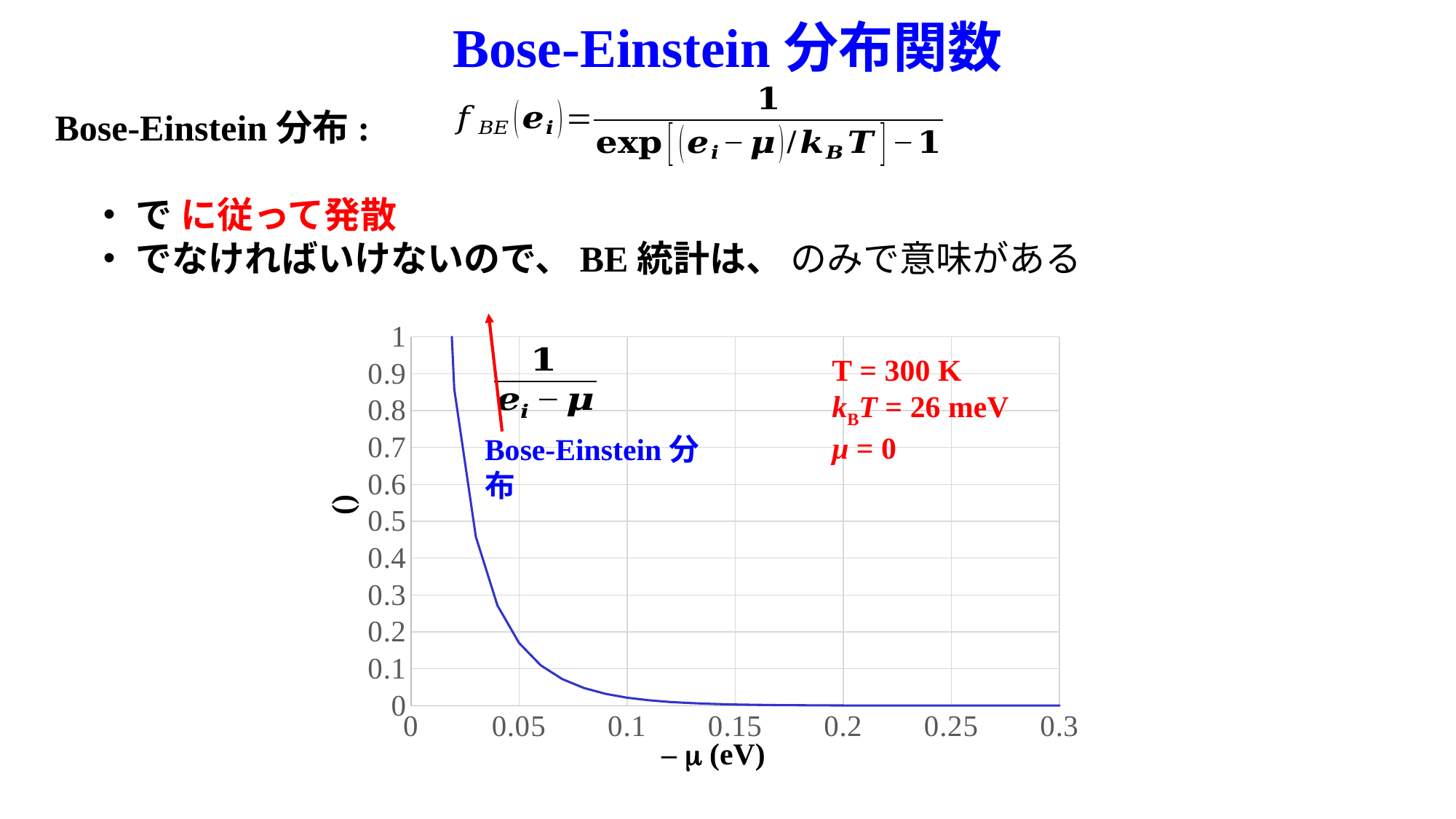
What temperature T is stated in the annotation on the chart? T = 300 K What is the largest tick value on the x axis? 0.3 What kind of chart is shown on the slide? line chart Does the plotted Bose-Einstein distribution curve rise or fall as the x-axis value increases? fall Is the value of the curve at x = 0.05 greater or less than 0.5? less Is the value of the curve at x = 0.05 greater or less than 0.1? greater What is the maximum value shown on the y axis? 1 Is the value of the curve at x = 0.2 greater or less than 0.1? less Which is larger, the value of the curve at x = 0.05 or at x = 0.15? x = 0.05